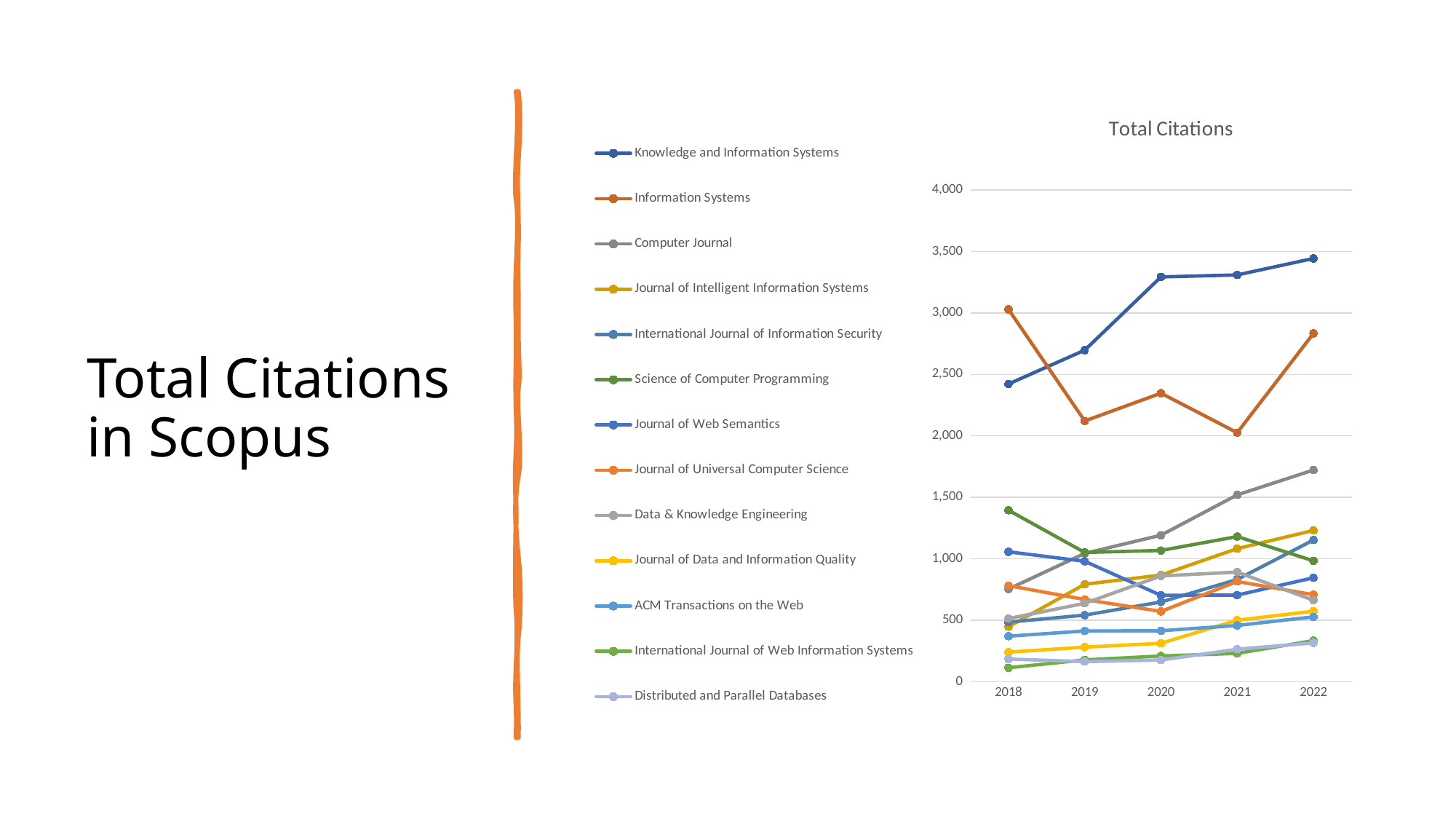
What kind of chart is shown on the slide? line chart How many series does the legend list? 13 Is the value for Computer Journal in 2022 greater or less than 1,500? greater Which series has the highest value in 2022? Knowledge and Information Systems Which series has the lowest value in 2018? International Journal of Web Information Systems Is the value for Information Systems in 2021 greater or less than 2,500? less What is the title of the chart? Total Citations In 2020, which is larger: Knowledge and Information Systems or Information Systems? Knowledge and Information Systems Which series has the highest value in 2018? Information Systems Do the values for Knowledge and Information Systems rise or fall from 2018 to 2022? rise Is the value for Knowledge and Information Systems in 2022 greater or less than 3,000? greater How many years are shown on the x axis? 5